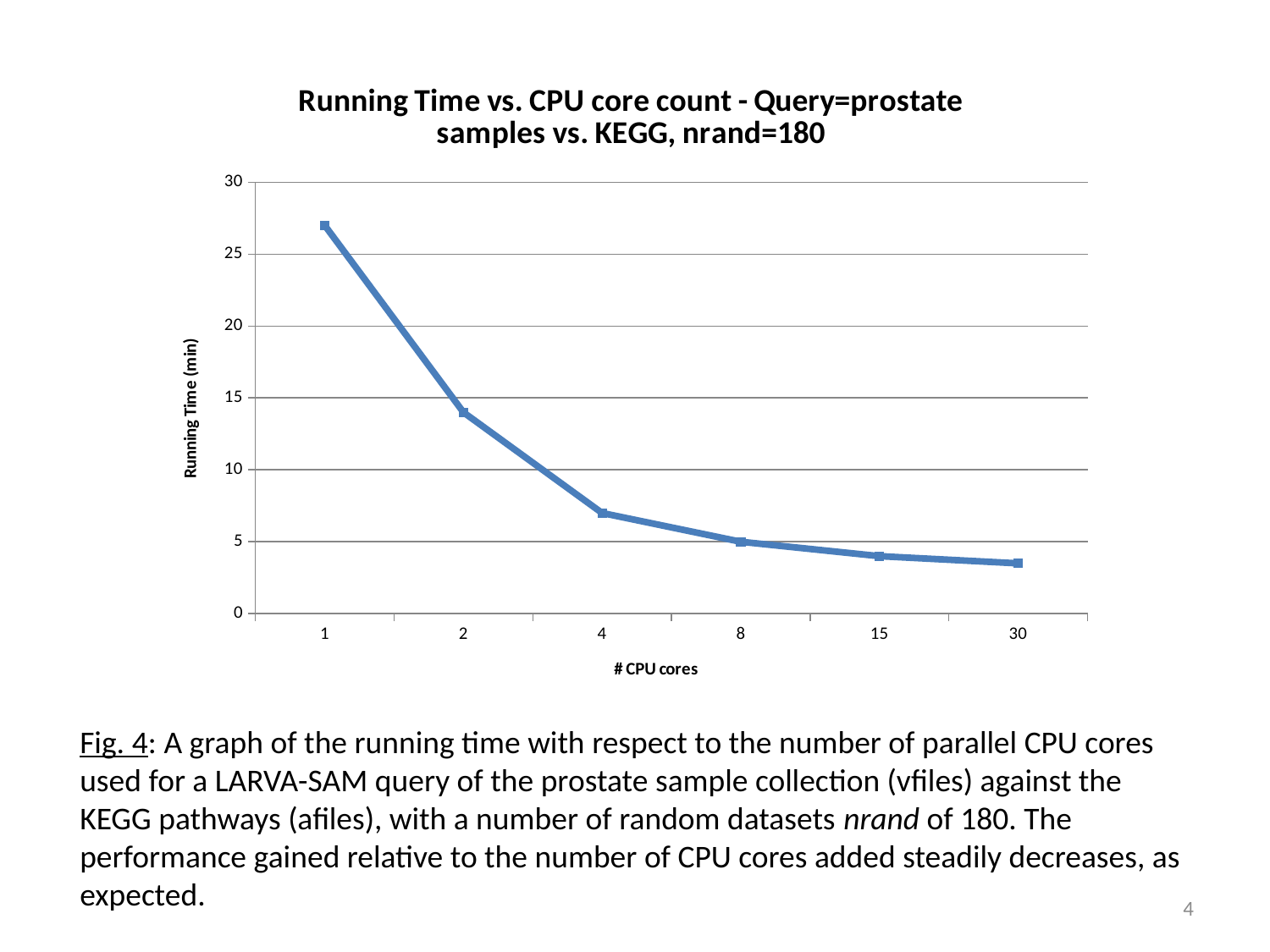
Is the running time for 2 CPU cores greater or less than 10? greater Does the running time rise or fall as the number of CPU cores increases? fall What is the label of the y axis? Running Time (min) How many CPU core counts are plotted on the x axis? 6 Which CPU core count has the highest running time? 1 Is the running time for 4 CPU cores greater or less than 5? greater Is the running time for 1 CPU core greater or less than 25? greater What is the label of the x axis? # CPU cores What kind of chart is shown on the slide? line chart Which has the larger running time, 2 CPU cores or 4 CPU cores? 2 CPU cores